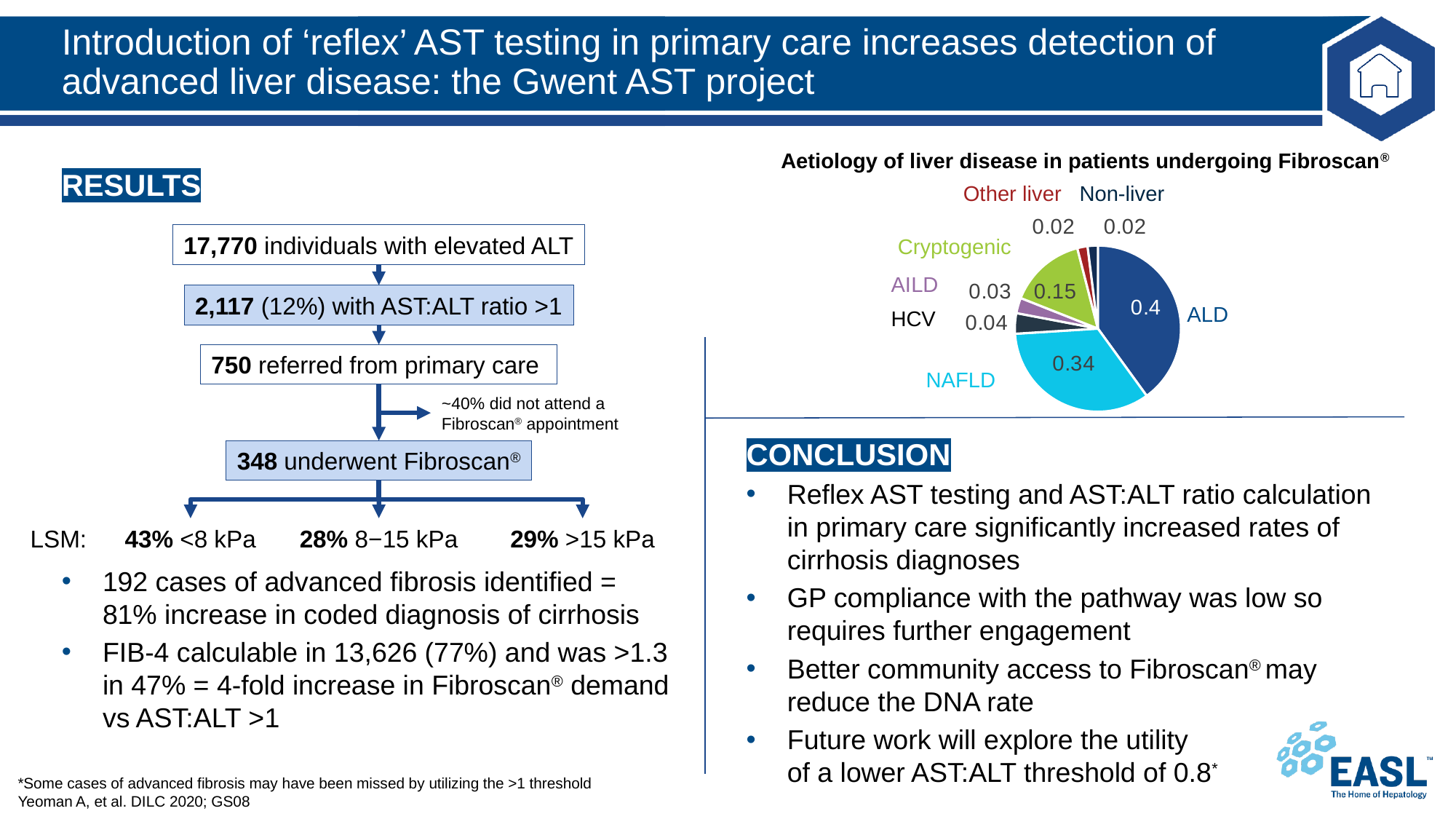
What is the title of the pie chart on the slide? Aetiology of liver disease in patients undergoing Fibroscan What is the value shown for AILD in the pie chart? 0.03 What is the value shown for NAFLD in the pie chart? 0.34 Which aetiology has the largest slice in the pie chart? ALD What is the difference between the ALD and NAFLD values in the pie chart? 0.06 What is the combined value of the Other liver and Non-liver slices in the pie chart? 0.04 What kind of chart is used to show the aetiology of liver disease in patients undergoing Fibroscan? Pie chart What is the value shown for HCV in the pie chart? 0.04 How many aetiology categories are shown in the pie chart? 7 Which is larger in the pie chart, the Cryptogenic value or the HCV value? Cryptogenic What is the value shown for Cryptogenic in the pie chart? 0.15 What is the value shown for ALD in the pie chart? 0.4